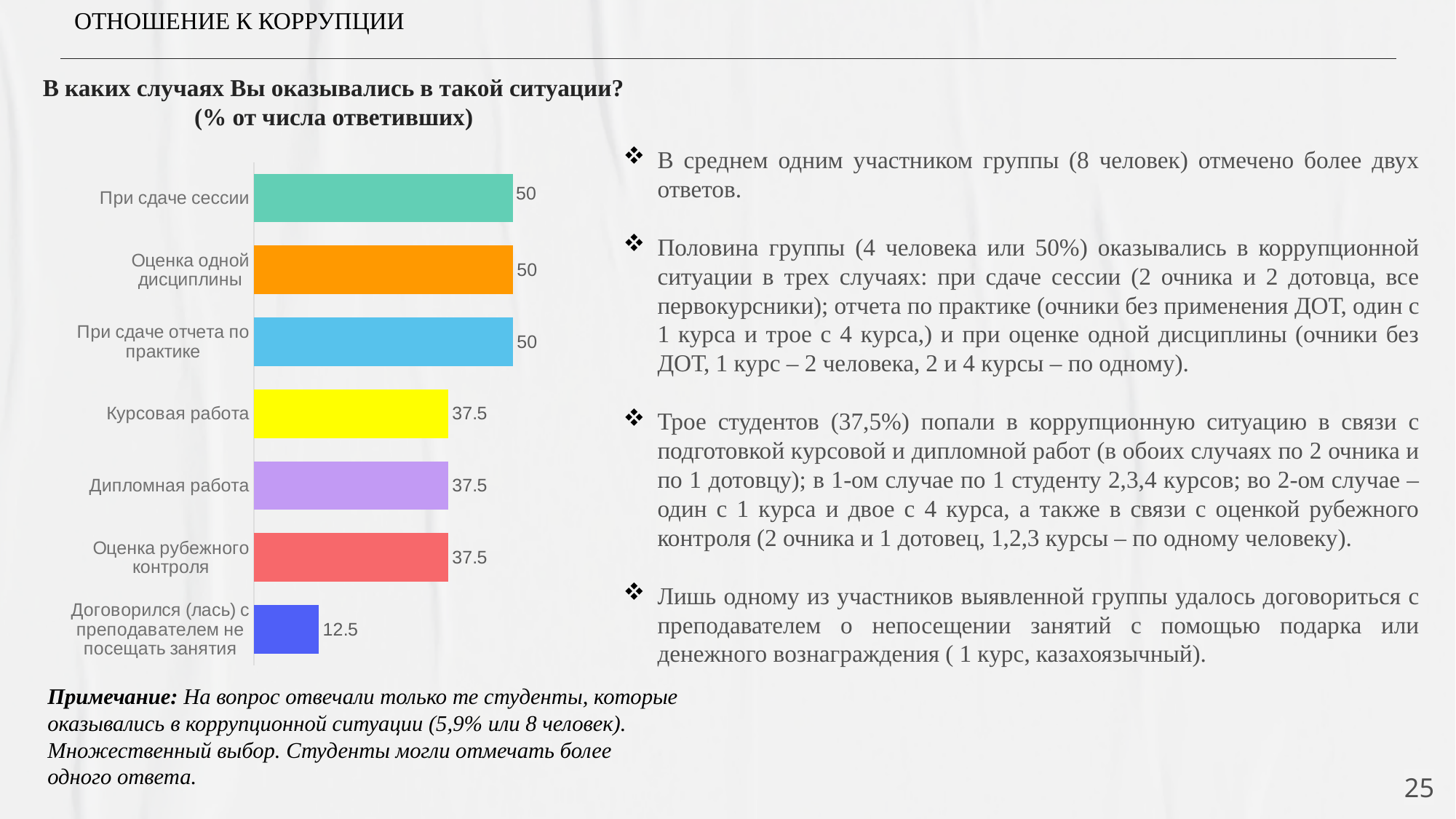
What is the value for "Курсовая работа"? 37.5 How many categories are shown in the chart? 7 Which is larger: the value for "При сдаче отчета по практике" or the value for "Дипломная работа"? При сдаче отчета по практике What type of chart is shown on the slide? Bar chart Which category has the lowest value? Договорился (лась) с преподавателем не посещать занятия What is the title of the chart? В каких случаях Вы оказывались в такой ситуации? (% от числа ответивших) How many categories have a value of 50? 3 What is the value for "Договорился (лась) с преподавателем не посещать занятия"? 12.5 What is the difference between the value for "Оценка одной дисциплины" and the value for "Курсовая работа"? 12.5 What is the value for "Оценка рубежного контроля"? 37.5 What is the difference between the value for "Дипломная работа" and the value for "Договорился (лась) с преподавателем не посещать занятия"? 25 What is the value for "При сдаче сессии"? 50